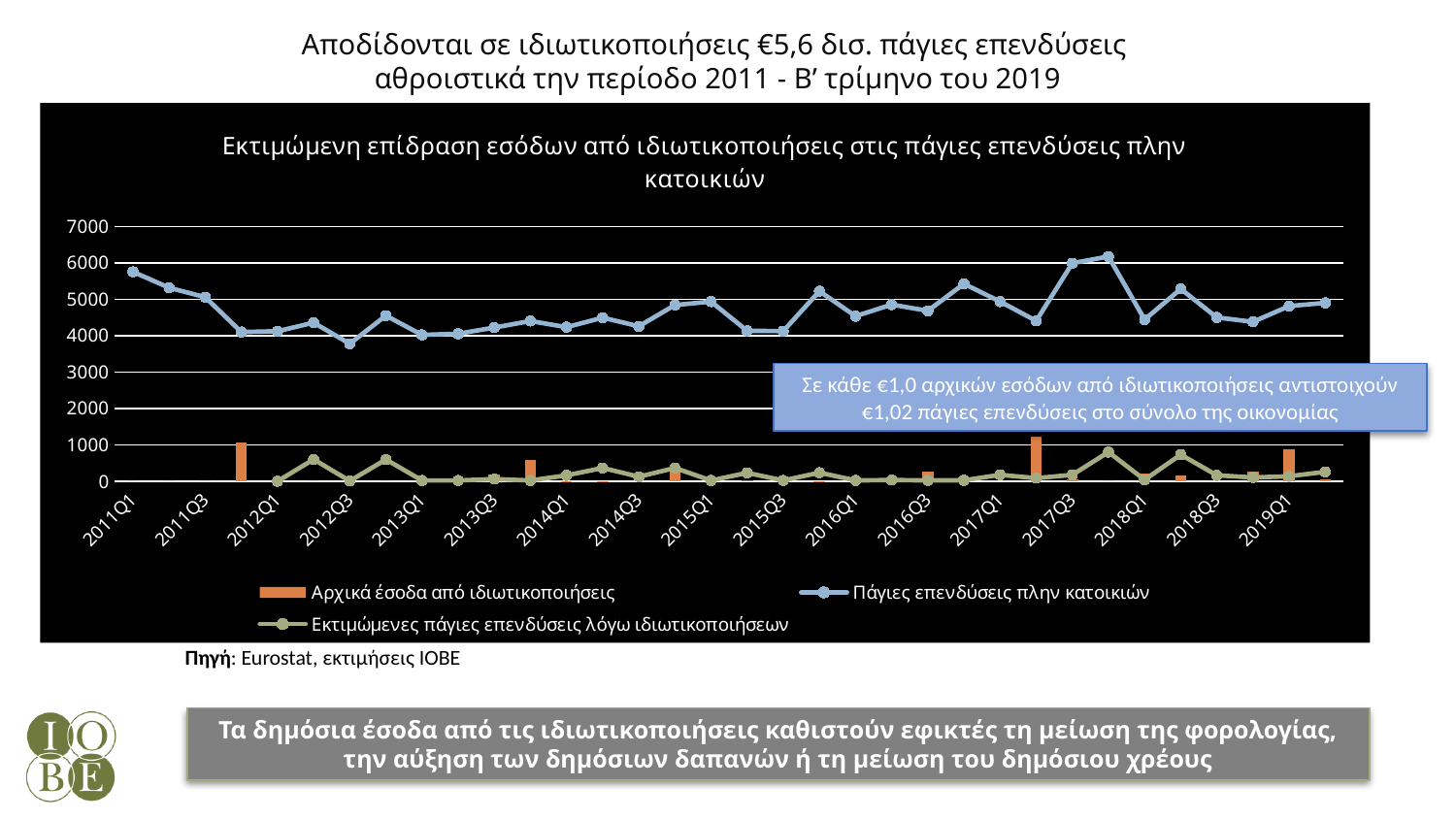
Is the value of Πάγιες επενδύσεις πλην κατοικιών in 2011Q1 greater or less than 5000? greater How many series does the chart legend list? 3 Which series in the chart is drawn as orange bars? Αρχικά έσοδα από ιδιωτικοποιήσεις Which is larger for Πάγιες επενδύσεις πλην κατοικιών: the value in 2017Q3 or the value in 2013Q1? 2017Q3 Does the line for Πάγιες επενδύσεις πλην κατοικιών rise or fall between 2011Q1 and 2012Q3? fall Is the value of Πάγιες επενδύσεις πλην κατοικιών in 2017Q3 greater or less than 5000? greater What kind of chart is shown on the slide? A combined bar and line chart Is the value of Πάγιες επενδύσεις πλην κατοικιών in 2012Q3 greater or less than 4000? less Which is larger for Πάγιες επενδύσεις πλην κατοικιών: the value in 2011Q1 or the value in 2012Q3? 2011Q1 In which quarter is the bar for Αρχικά έσοδα από ιδιωτικοποιήσεις the tallest? 2017Q2 What is the title of the chart? Εκτιμώμενη επίδραση εσόδων από ιδιωτικοποιήσεις στις πάγιες επενδύσεις πλην κατοικιών